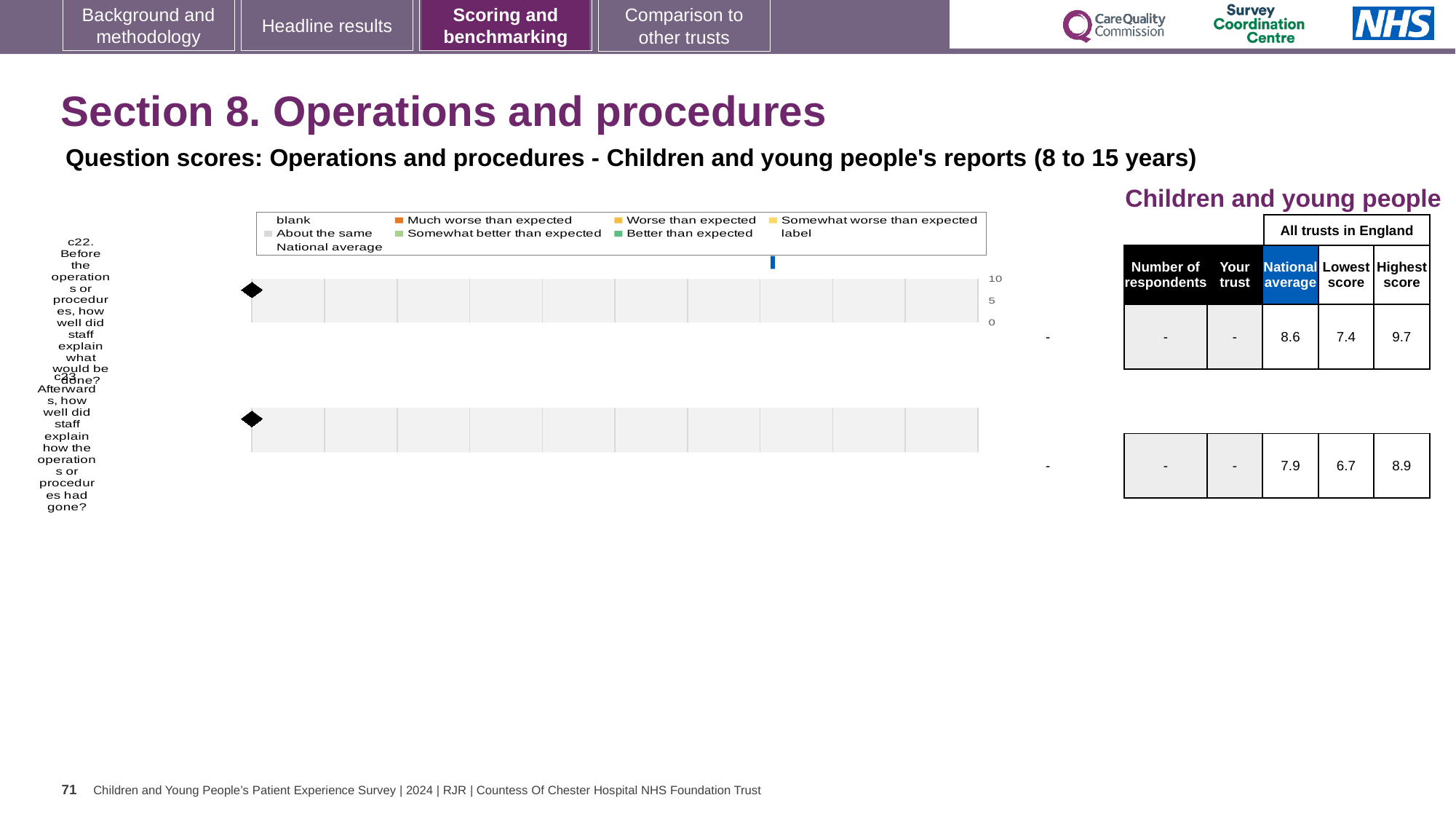
Is the national average for question c23 greater or less than 5? greater What is the highest score among all trusts in England for question c23? 8.9 What is the national average score for question c22 (Before the operations or procedures, how well did staff explain what would be done?)? 8.6 What is the difference between the highest and lowest scores for question c22? 2.3 How many entries does the chart legend list? 9 What is the highest value shown on the chart's numeric axis? 10 How many questions (categories) are shown on the chart's vertical axis? 2 What is the difference between the national averages of c22 and c23? 0.7 What is the lowest score among all trusts in England for question c22? 7.4 What value is shown for 'Your trust' for question c22? - Which question has the higher national average, c22 or c23? c22 What is the national average score for question c23 (Afterwards, how well did staff explain how the operations or procedures had gone?)? 7.9